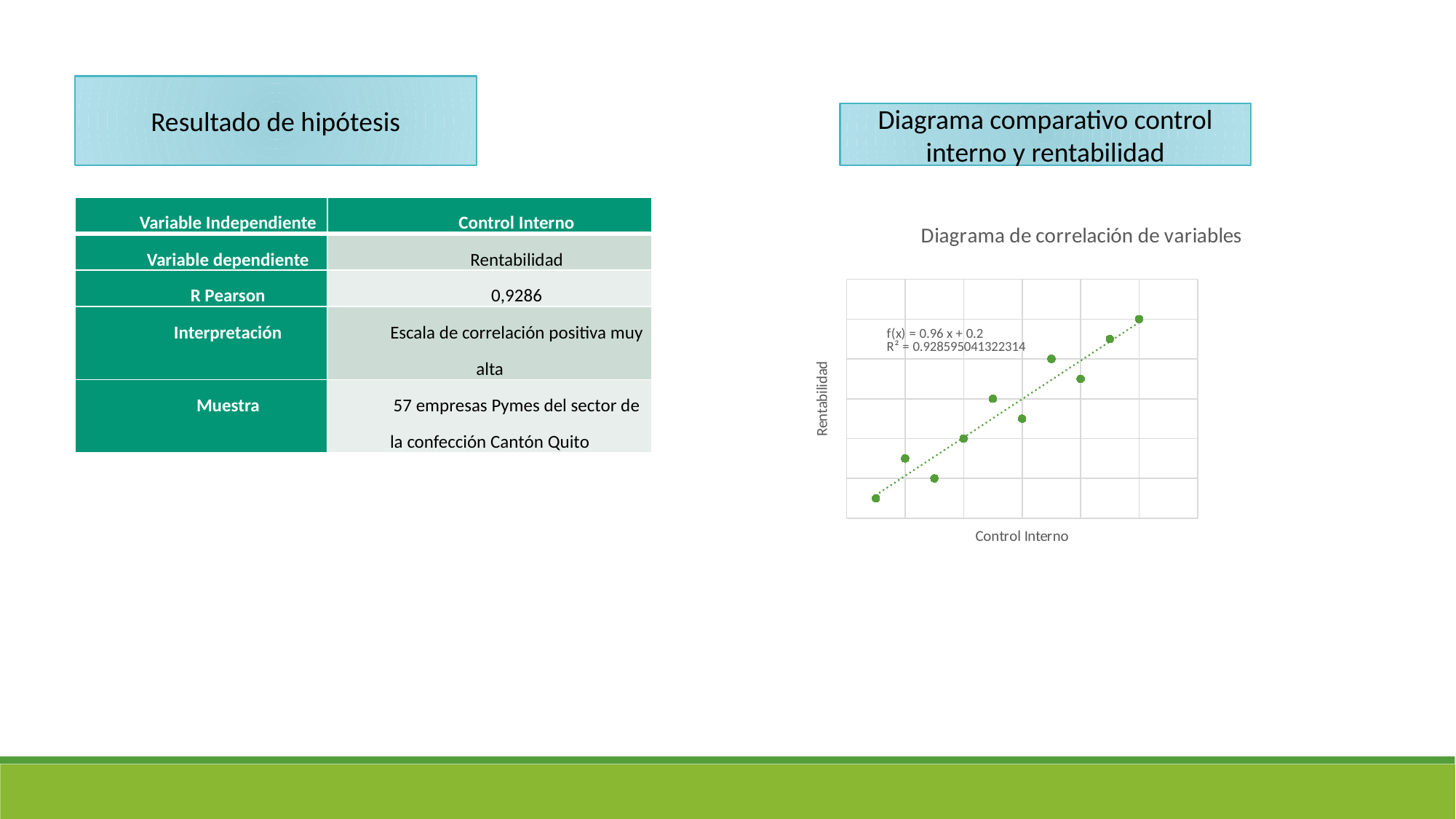
What is the label of the y axis of the scatter chart? Rentabilidad What kind of chart is shown under the title 'Diagrama de correlación de variables'? Scatter chart What trendline equation is printed on the scatter chart? f(x) = 0.96 x + 0.2 What is the title of the chart? Diagrama de correlación de variables Does the point with the highest Control Interno value also have the highest Rentabilidad value? Yes How many data points are plotted in the scatter chart? 10 Do the values of Rentabilidad generally rise or fall as Control Interno increases along the x axis? Rise What is the label of the x axis of the scatter chart? Control Interno Does the point with the lowest Control Interno value also have the lowest Rentabilidad value? Yes What is the slope of the trendline shown on the scatter chart? 0.96 What R² value is printed on the scatter chart? R² = 0.928595041322314